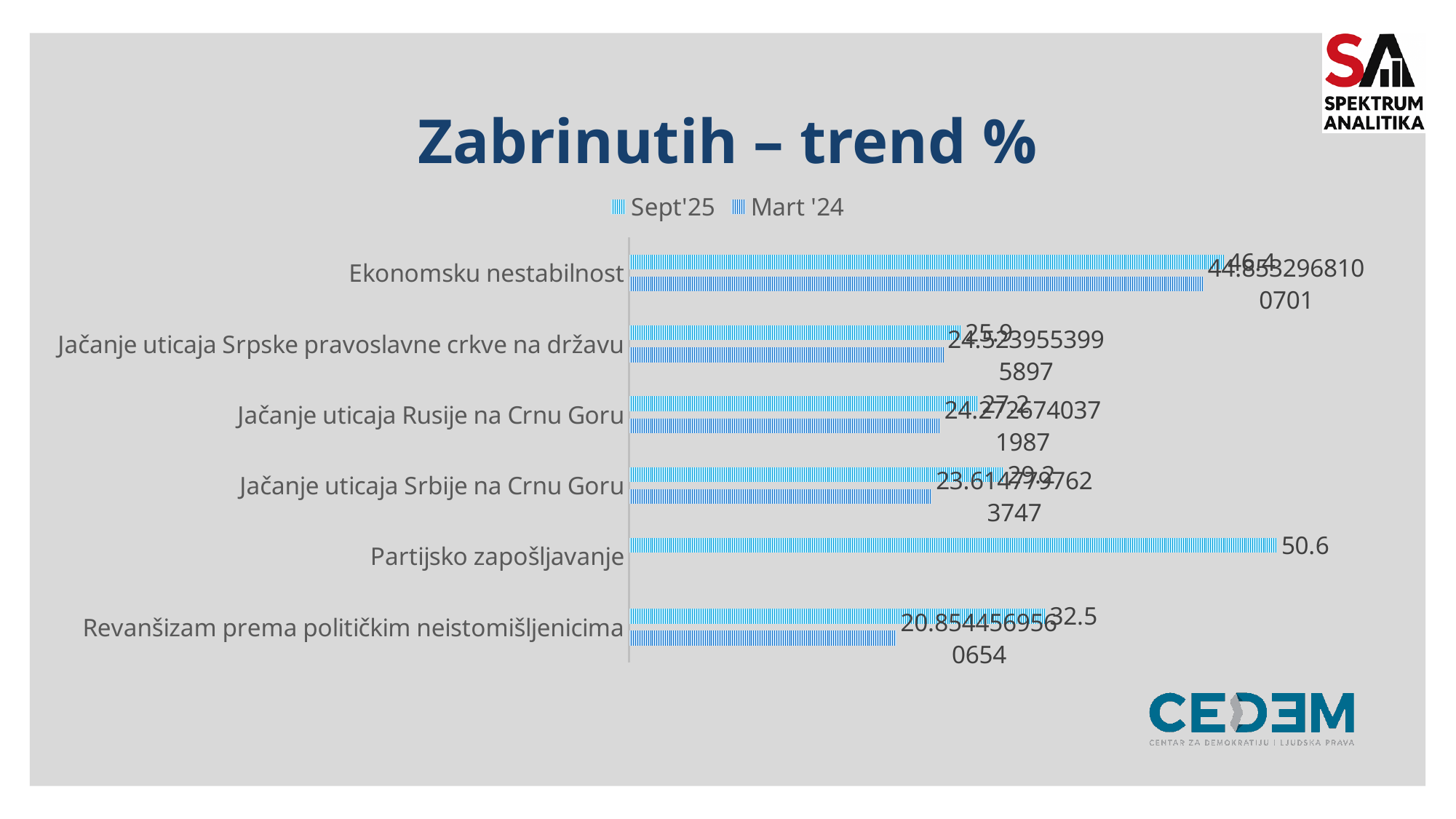
Which category has the highest Mart '24 value? Ekonomsku nestabilnost What kind of chart is shown on the slide? bar chart What is the Sept'25 value for Partijsko zapošljavanje? 50.6 Which category has the lowest Sept'25 value? Jačanje uticaja Srpske pravoslavne crkve na državu How many categories are shown on the chart? 6 What is the Sept'25 value for Ekonomsku nestabilnost? 46.4 What is the difference between the Sept'25 values for Partijsko zapošljavanje and Ekonomsku nestabilnost? 4.2 Which category has the highest Sept'25 value? Partijsko zapošljavanje Which category has a bar for only one of the two series? Partijsko zapošljavanje What is the Sept'25 value for Revanšizam prema političkim neistomišljenicima? 32.5 How many series does the legend list? 2 For Sept'25, which is larger: Ekonomsku nestabilnost or Partijsko zapošljavanje? Partijsko zapošljavanje